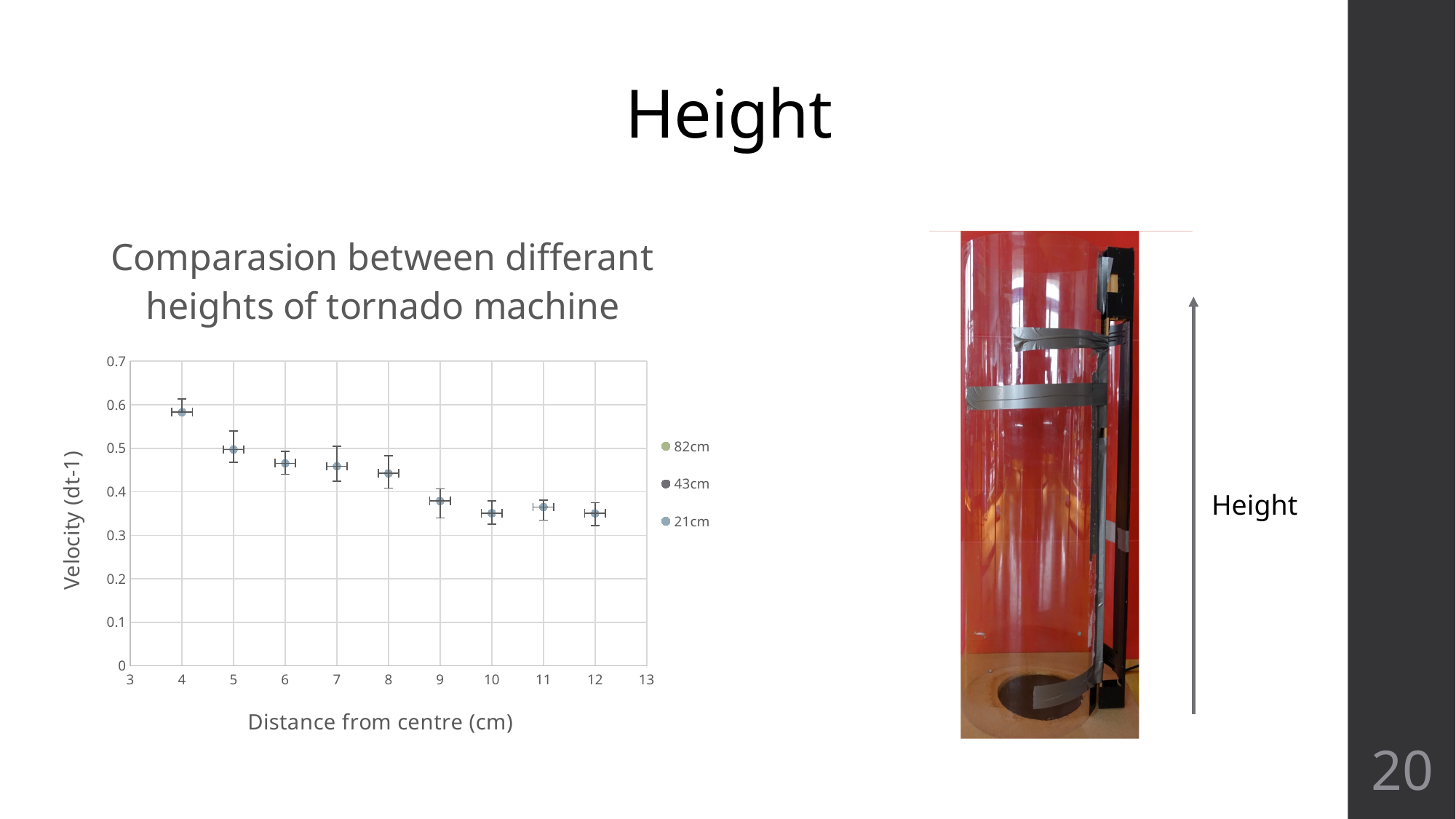
What is the title of the chart? Comparasion between differant heights of tornado machine What is the label of the x axis of the chart? Distance from centre (cm) What kind of chart is shown on the slide? scatter chart Is the velocity at a distance of 8 cm greater or less than 0.4? greater Is the velocity at a distance of 6 cm greater or less than 0.5? less Is the velocity at a distance of 10 cm greater or less than 0.4? less How many series does the chart legend list? 3 How many data points are plotted on the chart? 9 At which distance from centre is the plotted velocity highest? 4 Which has the larger velocity: the point at 5 cm or the point at 9 cm? 5 cm Do the plotted velocity values rise or fall as distance from centre increases? fall